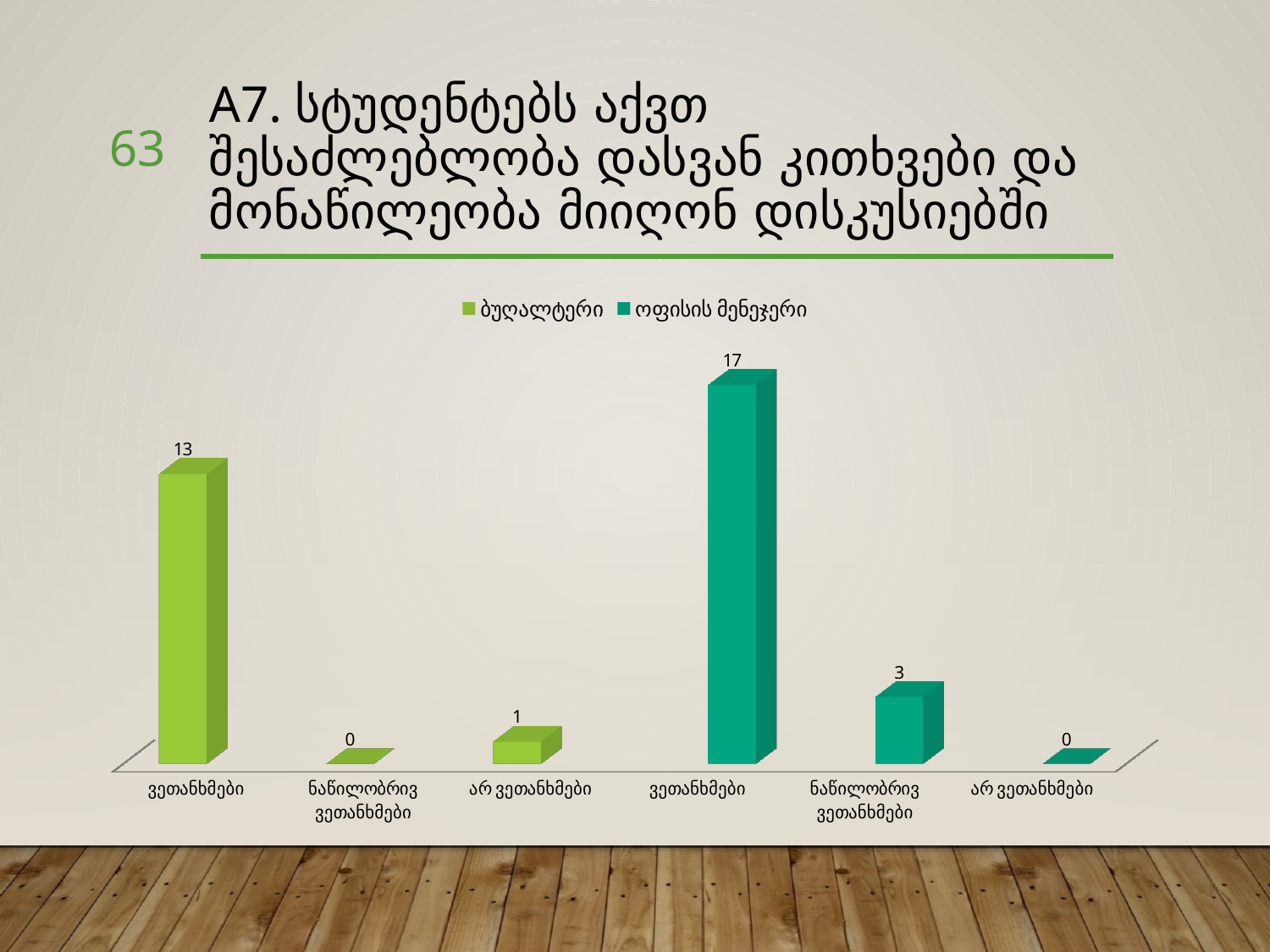
What is the value for ნაწილობრივ ვეთანხმები in the ოფისის მენეჯერი series? 3 What is the value for ვეთანხმები in the ბუღალტერი series? 13 What is the value for ნაწილობრივ ვეთანხმები in the ბუღალტერი series? 0 How many bars are plotted on the chart? 6 What is the value for არ ვეთანხმები in the ბუღალტერი series? 1 Which series is shown in the lighter green colour in the legend? ბუღალტერი What is the difference between the ვეთანხმები values of the ოფისის მენეჯერი and ბუღალტერი series? 4 Which is larger: ვეთანხმები for ბუღალტერი or ვეთანხმები for ოფისის მენეჯერი? ოფისის მენეჯერი What is the value for ვეთანხმები in the ოფისის მენეჯერი series? 17 Which bar has the highest value on the chart? ვეთანხმები (ოფისის მენეჯერი) How many series does the legend list? 2 What kind of chart is shown on the slide? bar chart